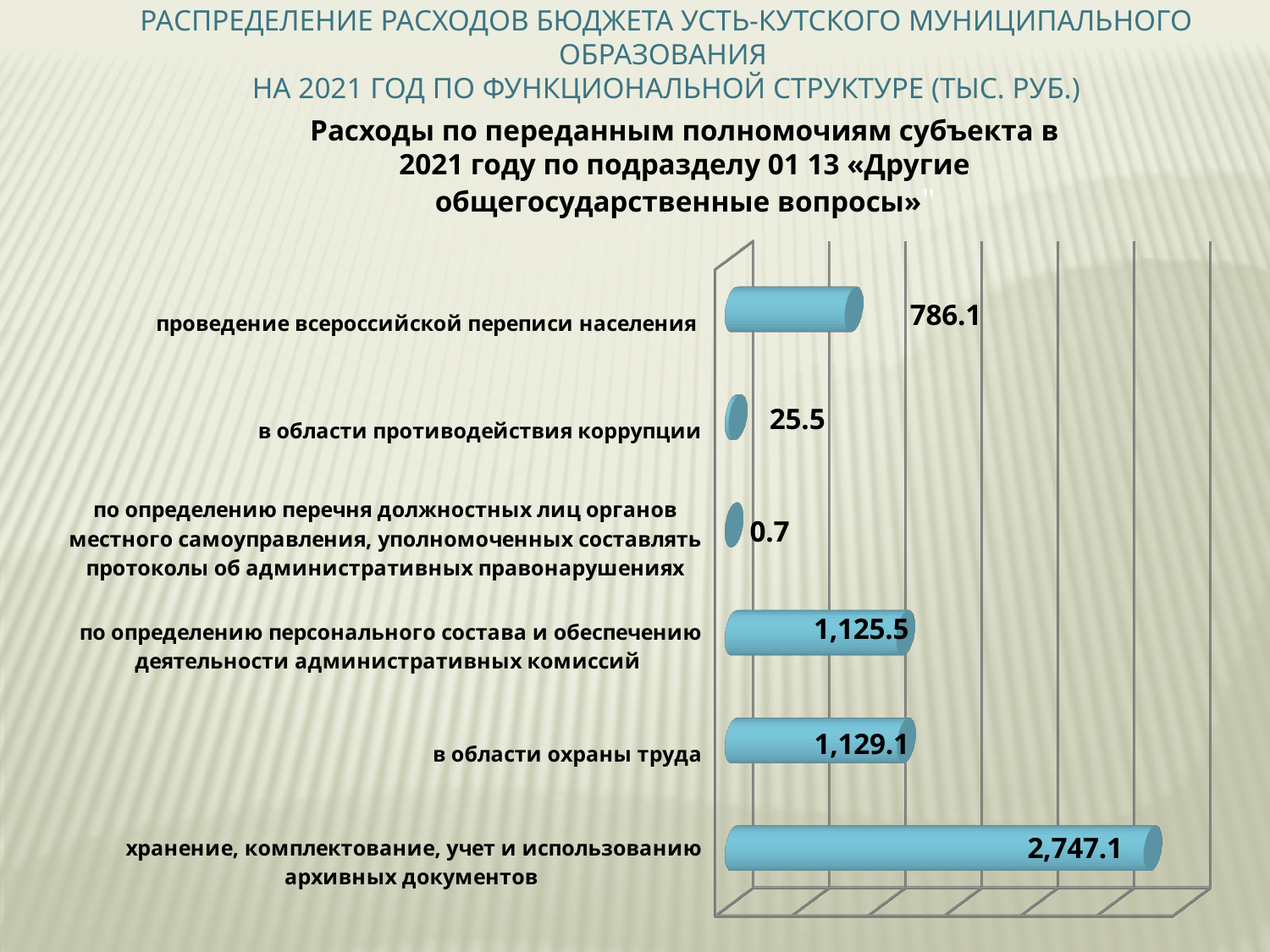
What kind of chart is shown on the slide? bar chart What is the difference between the values for «проведение всероссийской переписи населения» and «в области противодействия коррупции»? 760.6 What is the value for «хранение, комплектование, учет и использованию архивных документов»? 2,747.1 What is the value for «проведение всероссийской переписи населения»? 786.1 Which category has the lowest value? по определению перечня должностных лиц органов местного самоуправления, уполномоченных составлять протоколы об административных правонарушениях What is the value for «в области охраны труда»? 1,129.1 What is the value for «по определению персонального состава и обеспечению деятельности административных комиссий»? 1,125.5 How many categories are shown in the chart? 6 Which is larger: the value for «проведение всероссийской переписи населения» or the value for «в области охраны труда»? в области охраны труда Which category has the highest value? хранение, комплектование, учет и использованию архивных документов What is the value for «в области противодействия коррупции»? 25.5 What is the difference between the values for «хранение, комплектование, учет и использованию архивных документов» and «в области охраны труда»? 1,618.0